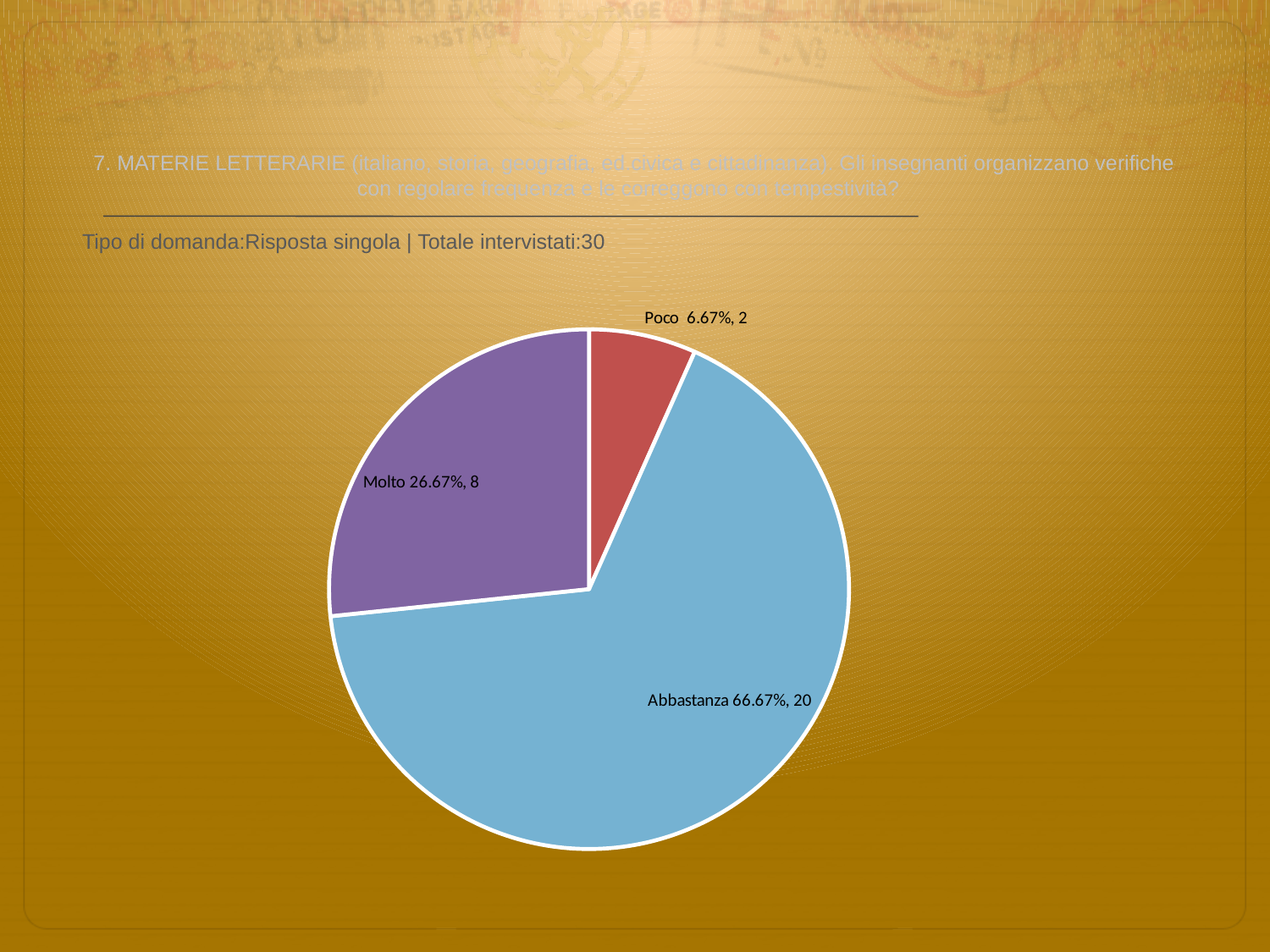
Which response has the smallest slice of the pie? Poco What percentage share does the Poco slice have? 6.67% How many respondents answered Abbastanza? 20 How many respondents answered Molto? 8 What percentage share does the Abbastanza slice have? 66.67% What is the difference in respondent count between Abbastanza and Molto? 12 How many respondents answered Poco? 2 How many slices does the pie chart have? 3 Which has more respondents, Molto or Poco? Molto Which response has the largest slice of the pie? Abbastanza What kind of chart is shown on the slide? pie chart What percentage share does the Molto slice have? 26.67%